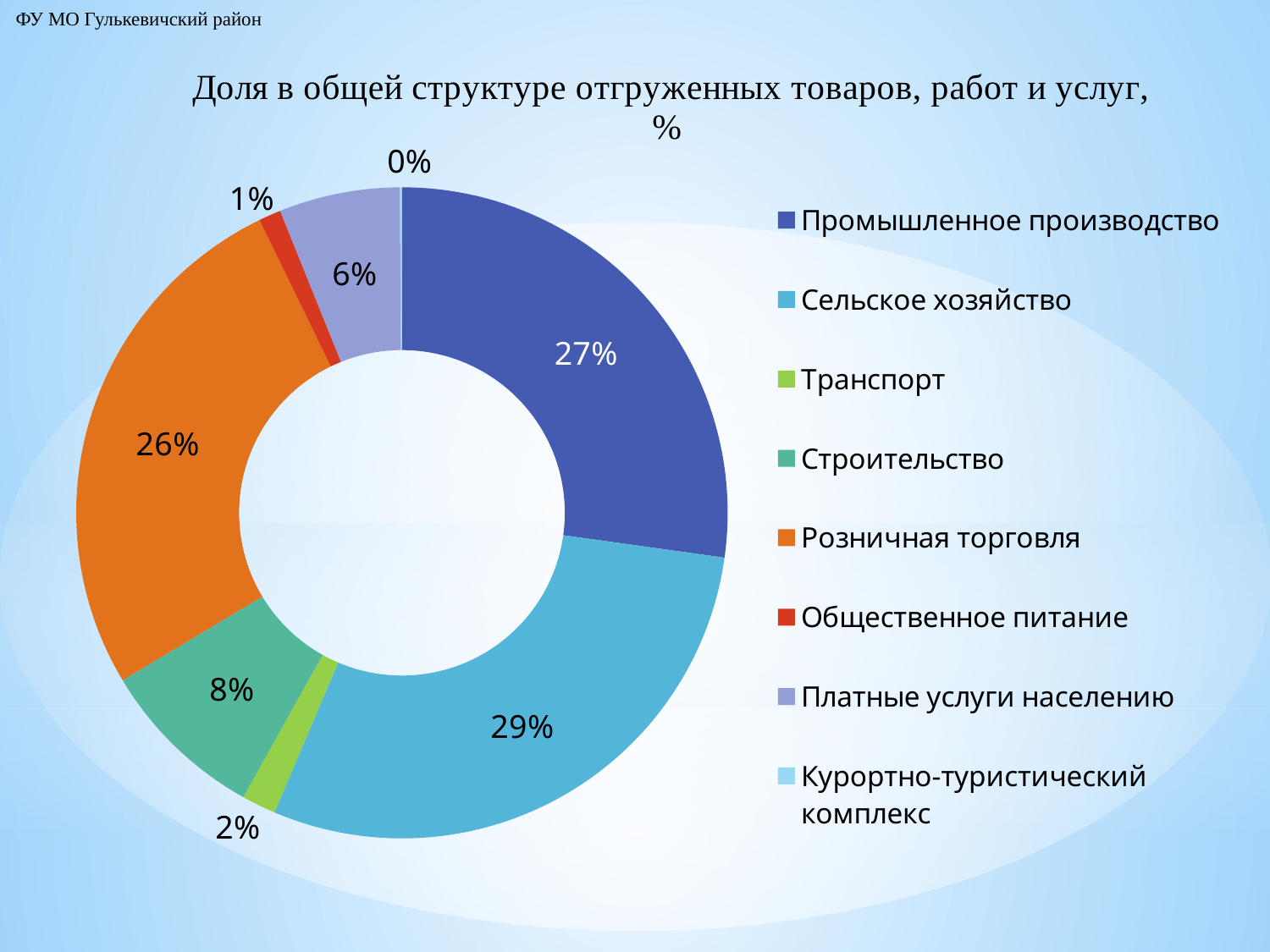
What is the difference between the shares of Сельское хозяйство and Промышленное производство? 2% What kind of chart is shown on the slide? Doughnut (pie) chart Which has a larger share, Строительство or Транспорт? Строительство Which category has the largest share? Сельское хозяйство What is the share for Строительство? 8% What is the share for Курортно-туристический комплекс? 0% What is the share for Промышленное производство? 27% What is the share for Сельское хозяйство? 29% What is the share for Платные услуги населению? 6% How many categories does the legend list? 8 Which category has the smallest share? Курортно-туристический комплекс What is the share for Розничная торговля? 26%